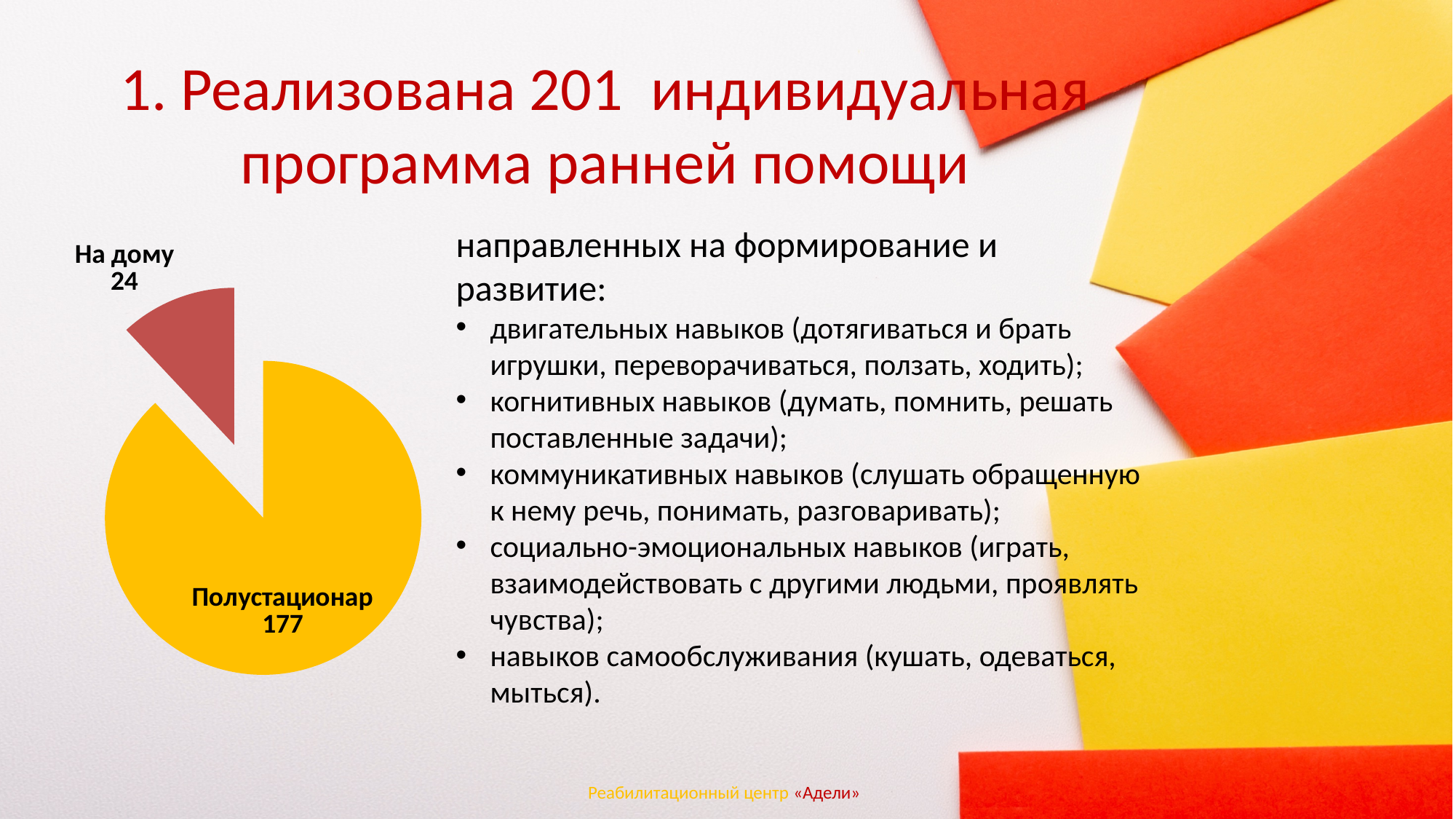
What is the difference between the values for Полустационар and На дому? 153 Which category has the largest slice in the pie chart? Полустационар Which is larger, the value for На дому or the value for Полустационар? Полустационар What share of the pie does На дому represent? 11.9% What colour is the На дому slice in the pie chart? Dark red What is the total of the two slices in the pie chart? 201 What colour is the Полустационар slice in the pie chart? Yellow What is the value for Полустационар in the pie chart? 177 Which category has the smallest slice in the pie chart? На дому What is the value for На дому in the pie chart? 24 What type of chart is shown on the slide? Pie chart How many categories does the pie chart show? 2